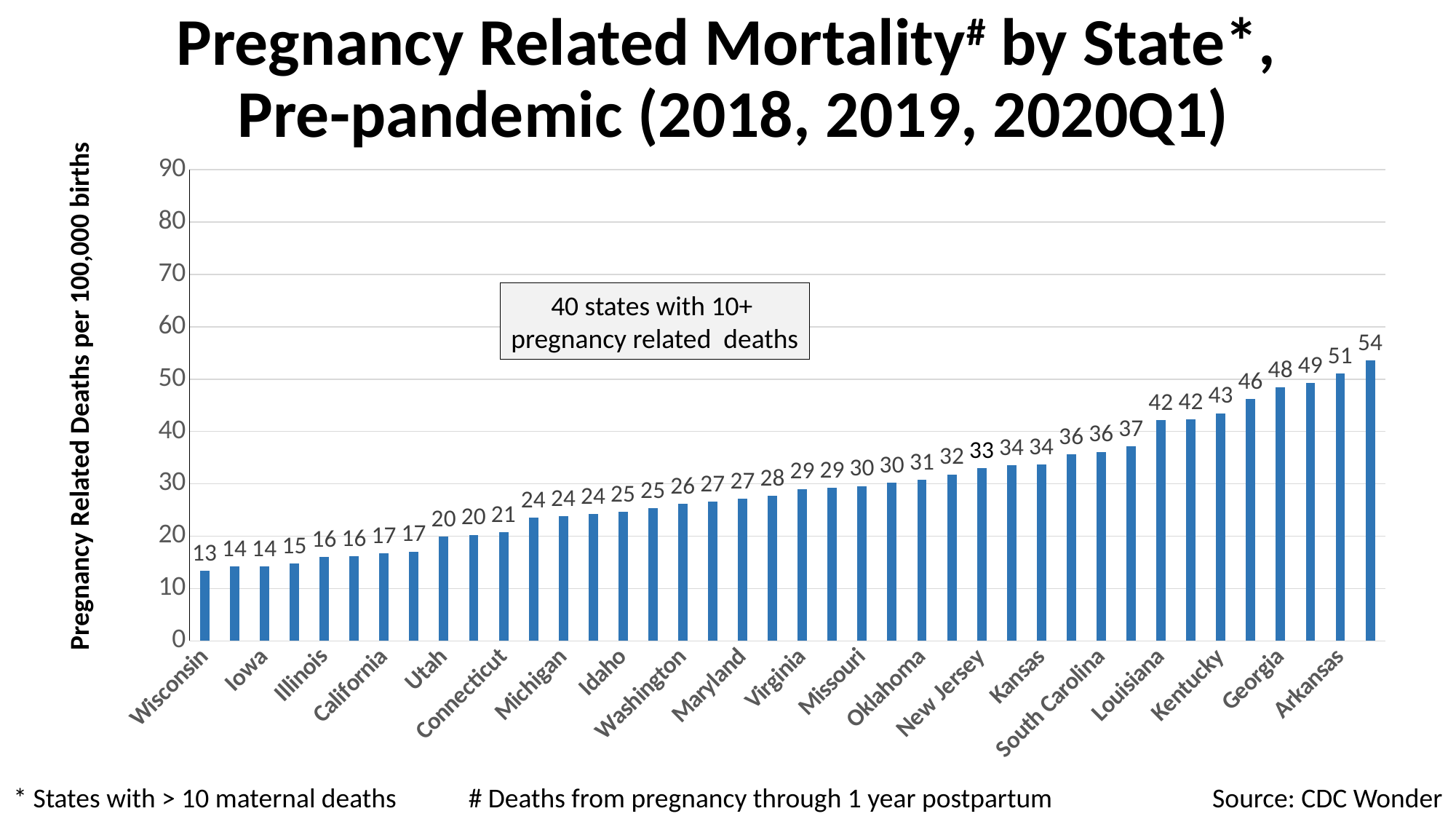
What kind of chart is shown on the slide? bar chart What is the pregnancy related mortality value for Georgia? 48 How many bars (states) are plotted in the chart? 40 Which labeled state has the lowest pregnancy related mortality? Wisconsin What is the difference between the values for Georgia and Wisconsin? 35 Is the value for Arkansas greater or less than 50? greater What is the label of the vertical axis? Pregnancy Related Deaths per 100,000 births Which has a higher value, Louisiana or Kansas? Louisiana Do the values rise or fall moving from left to right along the x axis? rise What is the pregnancy related mortality value for Wisconsin? 13 What is the pregnancy related mortality value for Louisiana? 42 What is the pregnancy related mortality value for Utah? 20